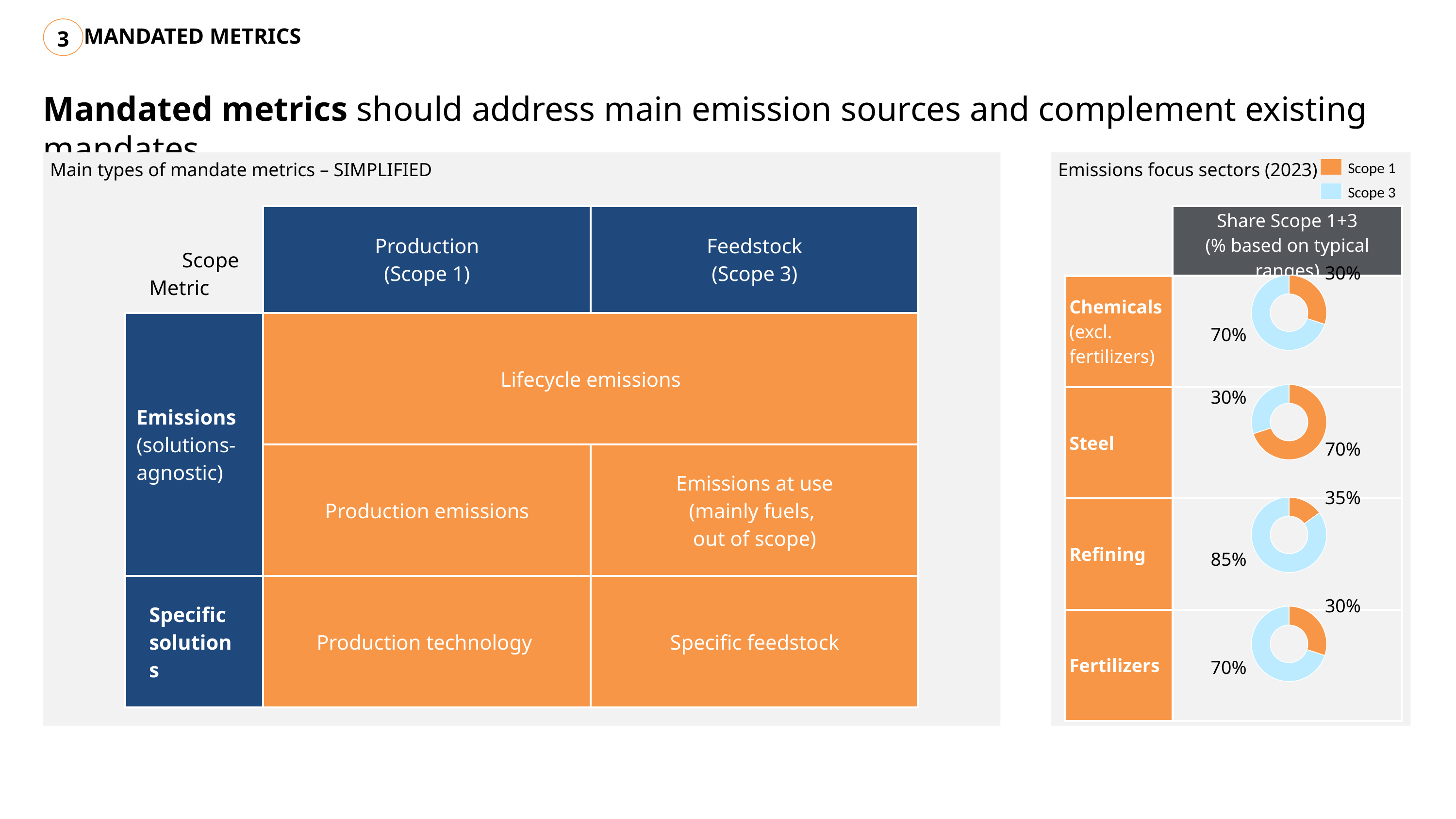
In the Emissions focus sectors (2023) charts, what is the Scope 3 share for Chemicals (excl. fertilizers)? 70% In the Emissions focus sectors (2023) charts, what is the Scope 1 share for Steel? 70% In the Emissions focus sectors (2023) charts, what is the Scope 1 share for Chemicals (excl. fertilizers)? 30% In the Emissions focus sectors (2023) charts, what is the Scope 1 share for Fertilizers? 30% How many series does the legend of the Emissions focus sectors (2023) charts list? 2 What kind of chart is used for the Emissions focus sectors (2023) panel? Donut (pie) chart In the Emissions focus sectors (2023) charts, which sector has the larger Scope 1 share, Steel or Chemicals (excl. fertilizers)? Steel In the Emissions focus sectors (2023) charts, what is the Scope 3 share for Steel? 30% In the Emissions focus sectors (2023) charts, which sector has the highest Scope 3 share? Refining In the Emissions focus sectors (2023) charts, what is the Scope 3 share for Fertilizers? 70% In the Emissions focus sectors (2023) charts, what is the Scope 3 share for Refining? 85% How many sectors are shown with a donut chart in the Emissions focus sectors (2023) panel? 4